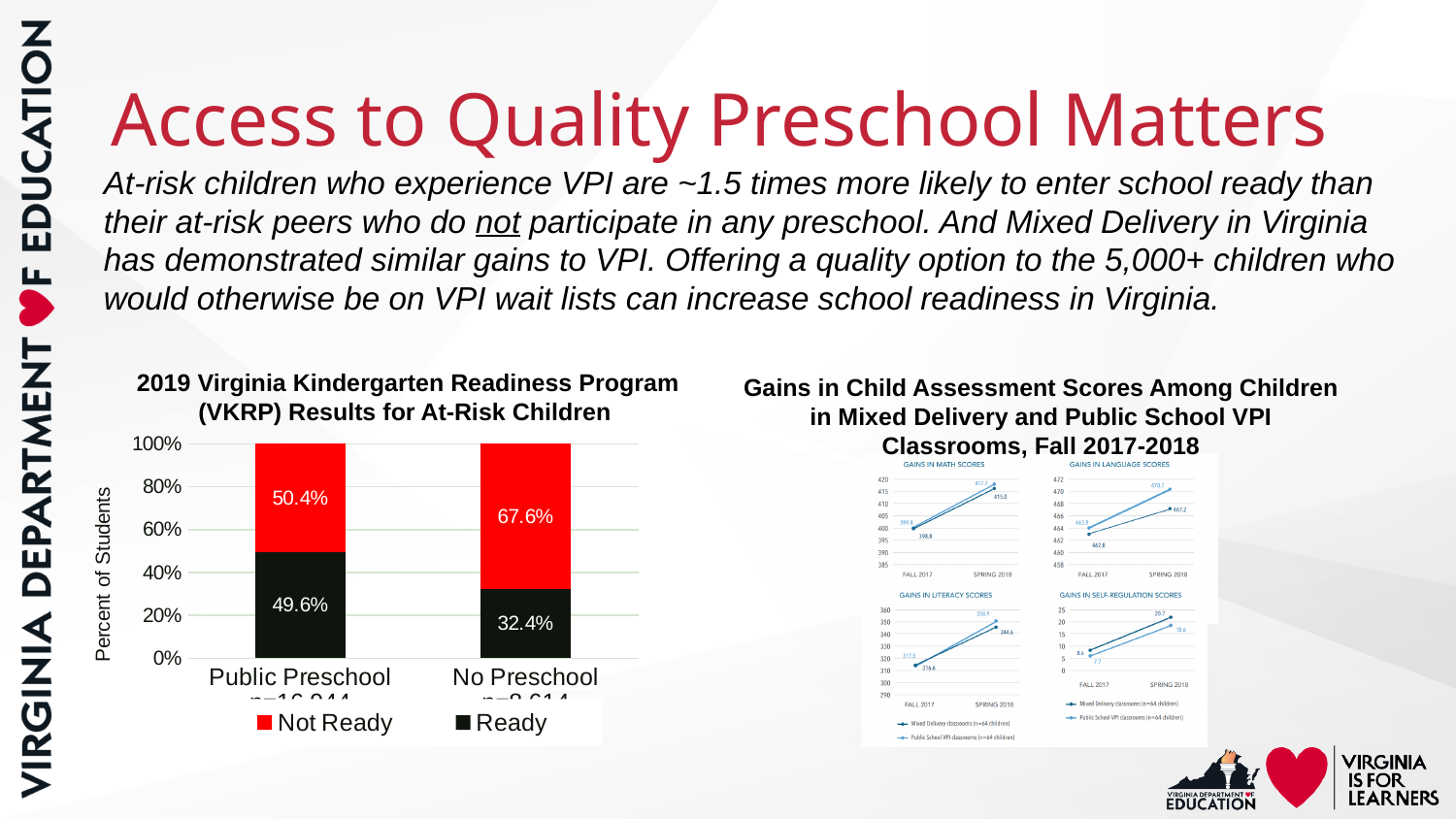
In the 2019 VKRP Results chart, what is the difference between the Ready percentages for Public Preschool and No Preschool? 17.2% In the 2019 VKRP Results chart, what is the total of the stacked bar for No Preschool? 100% What kind of chart is the 2019 VKRP Results chart? Stacked bar chart What is the y-axis label of the 2019 VKRP Results chart? Percent of Students In the 2019 VKRP Results chart, what is the Ready percentage for No Preschool? 32.4% In the 2019 VKRP Results chart, which colour represents Not Ready? Red In the 2019 VKRP Results chart, what percentage of at-risk children in Public Preschool were Ready? 49.6% How many series does the legend of the 2019 VKRP Results chart list? 2 In the 2019 VKRP Results chart, which category has the higher Ready percentage, Public Preschool or No Preschool? Public Preschool In the 2019 VKRP Results chart, what percentage of at-risk children with No Preschool were Not Ready? 67.6% In the 2019 VKRP Results chart, what is the difference between the Not Ready percentages for No Preschool and Public Preschool? 17.2% In the 2019 VKRP Results chart, what is the Not Ready percentage for Public Preschool? 50.4%